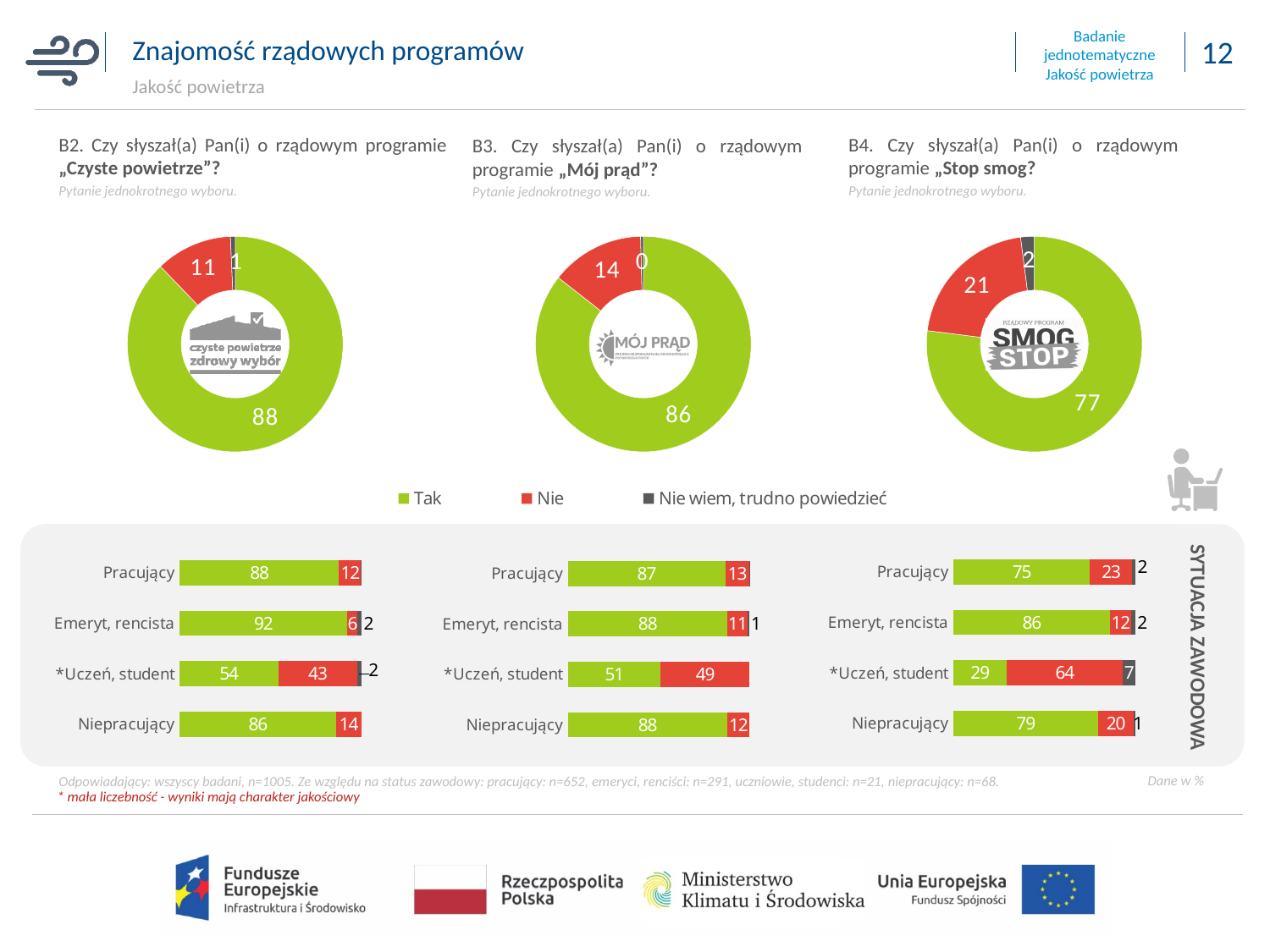
Across the three donut charts, which programme has the lowest "Tak" share? Stop smog How many employment categories are shown in each bar chart at the bottom of the slide? 4 In the donut chart for B3 "Mój prąd", what is the difference between the "Tak" and "Nie" shares? 72 In the donut chart for B4 "Stop smog", what percentage answered "Nie"? 21 In the bar chart for B2 "Czyste powietrze", what is the difference between the "Tak" and "Nie" values for *Uczeń, student? 11 In the bar chart for B2 "Czyste powietrze", what is the "Tak" value for Emeryt, rencista? 92 How many series does the legend list for the charts? 3 In the bar chart for B4 "Stop smog", what is the "Nie" value for *Uczeń, student? 64 What type of chart is used for the breakdown by employment status (Sytuacja zawodowa) at the bottom of the slide? Stacked bar chart In the bar chart for B3 "Mój prąd", which employment group has the lowest "Tak" value? *Uczeń, student In the bar chart for B4 "Stop smog", is the "Tak" value for Pracujący larger or smaller than for Niepracujący? Smaller In the donut chart for B2 "Czyste powietrze", what percentage answered "Tak"? 88